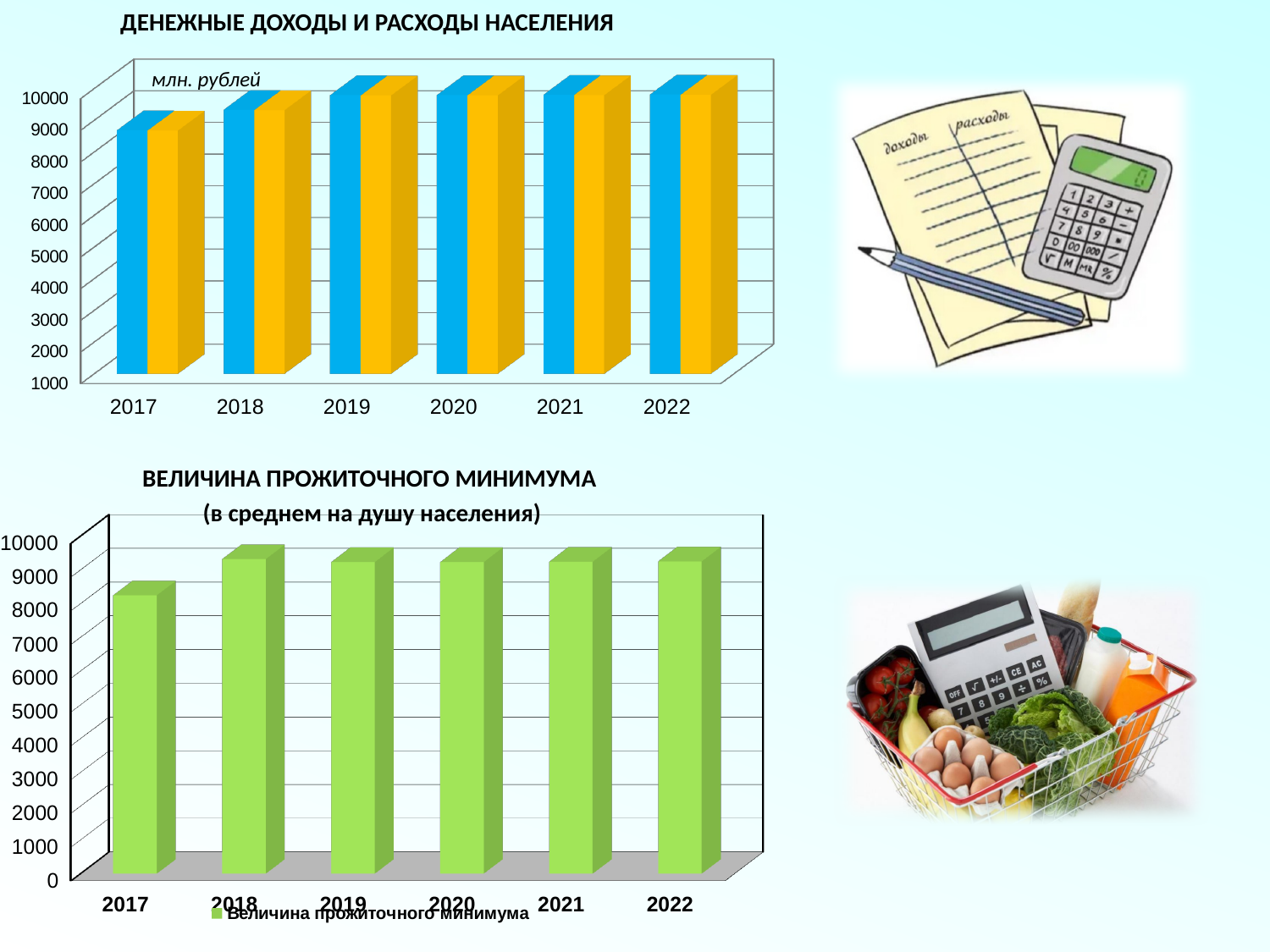
In the bottom chart "ВЕЛИЧИНА ПРОЖИТОЧНОГО МИНИМУМА", is the value for 2018 greater or less than 9000? greater What kind of chart is the top chart titled "ДЕНЕЖНЫЕ ДОХОДЫ И РАСХОДЫ НАСЕЛЕНИЯ"? bar chart What unit is written inside the plot area of the top chart "ДЕНЕЖНЫЕ ДОХОДЫ И РАСХОДЫ НАСЕЛЕНИЯ"? млн. рублей In the bottom chart "ВЕЛИЧИНА ПРОЖИТОЧНОГО МИНИМУМА", how many series does the legend list? 1 In the bottom chart "ВЕЛИЧИНА ПРОЖИТОЧНОГО МИНИМУМА", which is larger, the value for 2017 or the value for 2018? 2018 In the bottom chart "ВЕЛИЧИНА ПРОЖИТОЧНОГО МИНИМУМА", how many bars are plotted? 6 In the top chart "ДЕНЕЖНЫЕ ДОХОДЫ И РАСХОДЫ НАСЕЛЕНИЯ", which year has the lowest bars? 2017 In the top chart "ДЕНЕЖНЫЕ ДОХОДЫ И РАСХОДЫ НАСЕЛЕНИЯ", how many years are shown on the x axis? 6 In the bottom chart "ВЕЛИЧИНА ПРОЖИТОЧНОГО МИНИМУМА", is the value for 2017 greater or less than 7000? greater In the top chart "ДЕНЕЖНЫЕ ДОХОДЫ И РАСХОДЫ НАСЕЛЕНИЯ", is the blue bar for 2017 greater or less than 8000? greater What kind of chart is the bottom chart titled "ВЕЛИЧИНА ПРОЖИТОЧНОГО МИНИМУМА"? bar chart In the bottom chart "ВЕЛИЧИНА ПРОЖИТОЧНОГО МИНИМУМА", which year has the lowest value? 2017